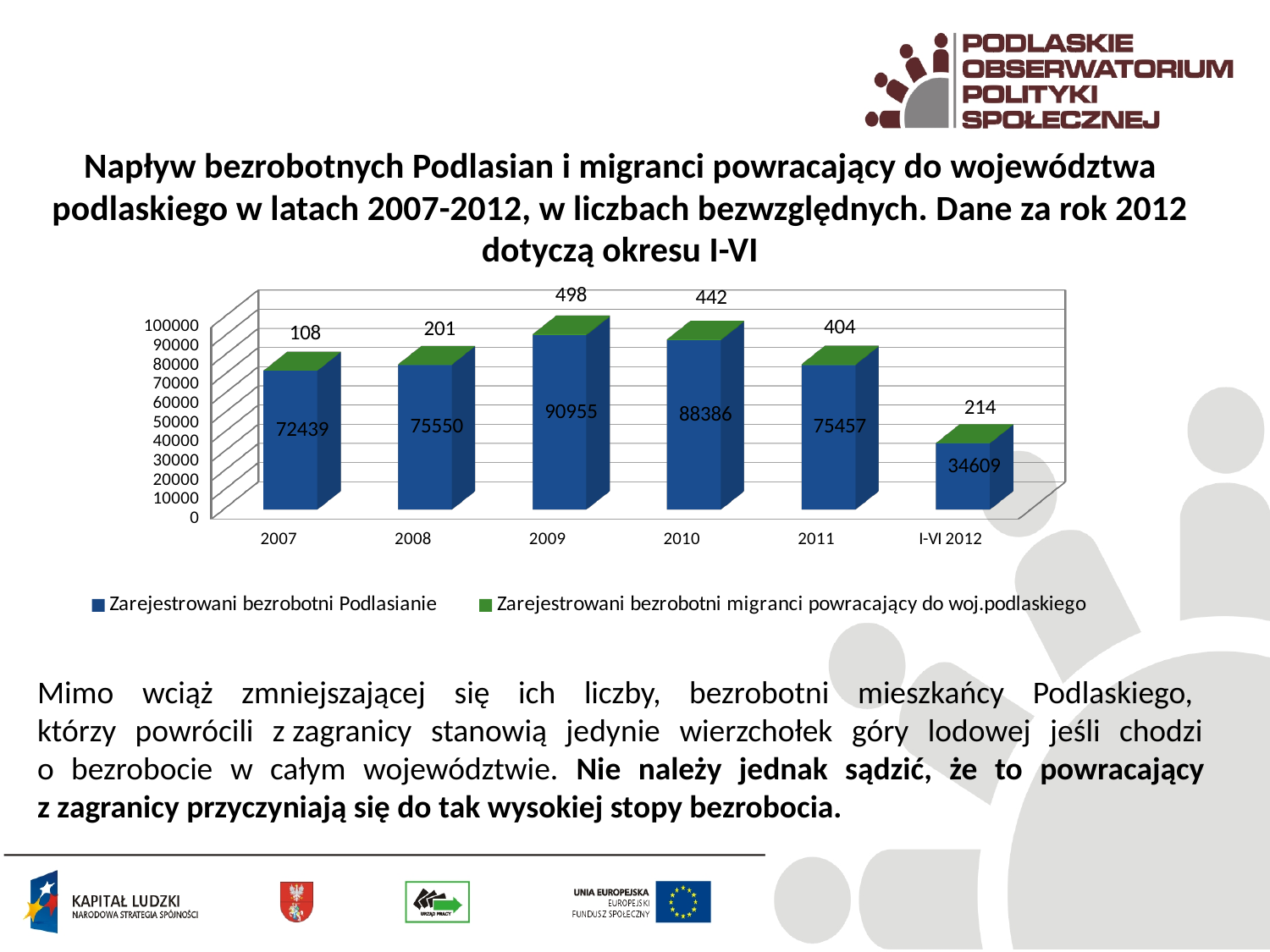
Which is larger, the Zarejestrowani bezrobotni migranci value for 2008 or for 2010? 2010 What is the value for Zarejestrowani bezrobotni migranci powracający do woj.podlaskiego in 2011? 404 Which colour represents Zarejestrowani bezrobotni Podlasianie in the chart? blue What is the value for Zarejestrowani bezrobotni Podlasianie in 2009? 90955 How many categories are shown on the x axis? 6 What is the total of the stacked bar for 2007? 72547 What kind of chart is shown on the slide? stacked bar chart In which category is the value for Zarejestrowani bezrobotni Podlasianie the lowest? I-VI 2012 How many series does the legend list? 2 What is the value for Zarejestrowani bezrobotni Podlasianie in I-VI 2012? 34609 In which year is the value for Zarejestrowani bezrobotni migranci powracający do woj.podlaskiego the highest? 2009 What is the difference between the Zarejestrowani bezrobotni Podlasianie values for 2009 and 2010? 2569